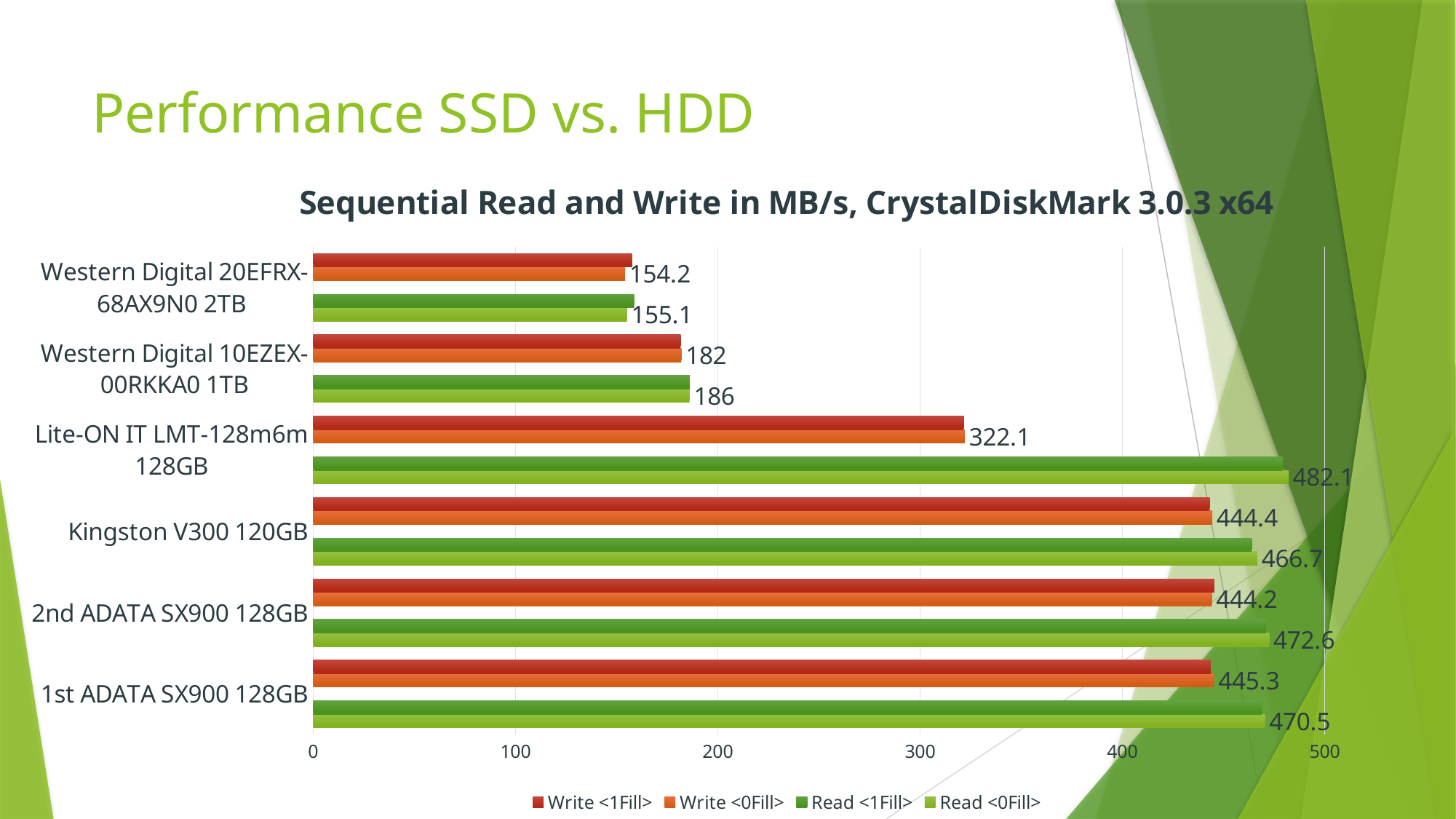
What is the difference between the Read <0Fill> values of the Western Digital 10EZEX-00RKKA0 1TB and the Western Digital 20EFRX-68AX9N0 2TB? 30.9 What is the Write <0Fill> value for the Western Digital 20EFRX-68AX9N0 2TB? 154.2 What is the difference between the Read <0Fill> and Write <0Fill> values for the Lite-ON IT LMT-128m6m 128GB? 160 How many series does the legend list? 4 Which drive has the lowest Write <0Fill> value? Western Digital 20EFRX-68AX9N0 2TB Is the Write <1Fill> value for the Lite-ON IT LMT-128m6m 128GB greater or less than 400? less What is the Read <0Fill> value for the Lite-ON IT LMT-128m6m 128GB? 482.1 What is the Write <0Fill> value for the Western Digital 10EZEX-00RKKA0 1TB? 182 Which is larger: the Read <0Fill> value for the Lite-ON IT LMT-128m6m 128GB or for the 1st ADATA SX900 128GB? Lite-ON IT LMT-128m6m 128GB Which drive has the highest Read <0Fill> value? Lite-ON IT LMT-128m6m 128GB What type of chart is shown on the slide? bar chart How many drives are listed on the chart? 6